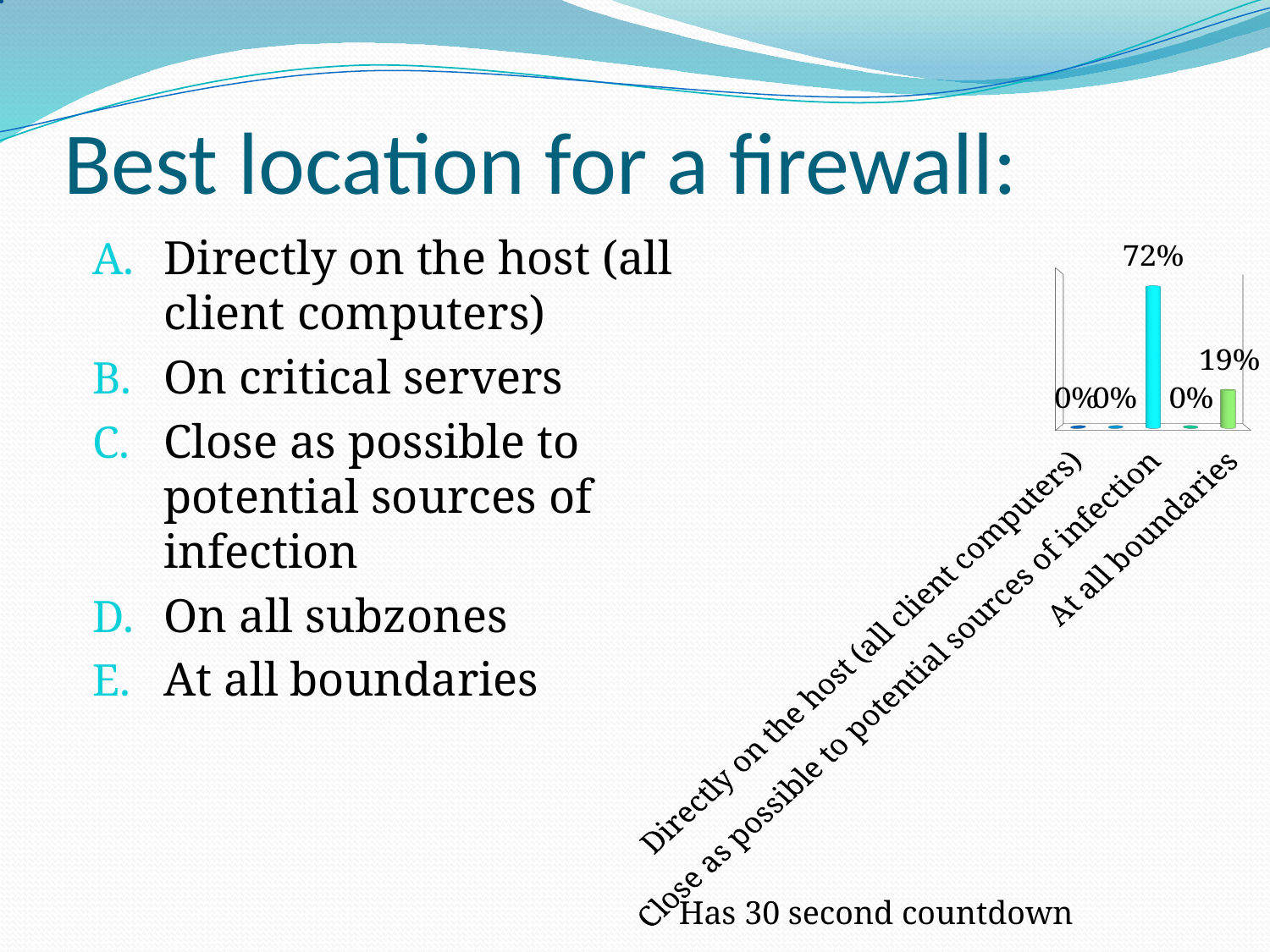
What is the value for 'Close as possible to potential sources of infection'? 72% What is the highest value shown in the chart? 72% What colour is the bar for 'At all boundaries'? green How many bars in the chart have a value of 0%? 3 What is the difference between the values for 'Close as possible to potential sources of infection' and 'At all boundaries'? 53% What colour is the tallest bar in the chart? cyan What is the value for 'At all boundaries'? 19% Which category has the highest value? Close as possible to potential sources of infection Which is larger: the value for 'At all boundaries' or the value for 'Directly on the host (all client computers)'? At all boundaries What kind of chart is shown on the slide? bar chart What is the value for 'Directly on the host (all client computers)'? 0% How many bars does the chart show? 5